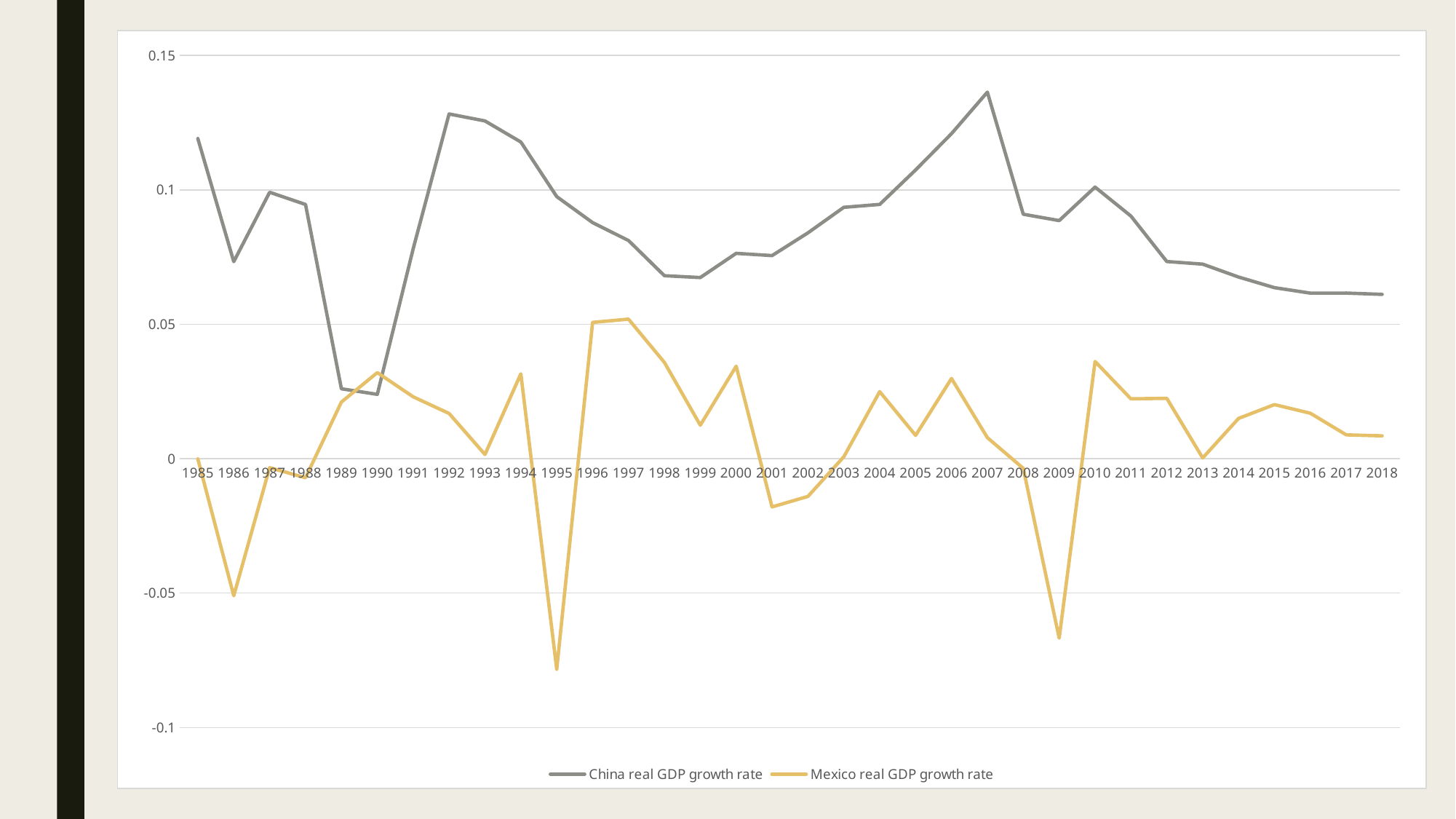
What kind of chart is shown on the slide? line chart Which series has the larger value in 2000, China real GDP growth rate or Mexico real GDP growth rate? China real GDP growth rate In which year does the China real GDP growth rate reach its highest value? 2007 How many series does the legend list? 2 Is the China real GDP growth rate in 1990 greater or less than 0.05? less Is the Mexico real GDP growth rate in 1986 greater or less than 0? less What colour is the line for the Mexico real GDP growth rate? yellow Does the China real GDP growth rate rise or fall from 2010 to 2018? fall Is the Mexico real GDP growth rate in 2009 greater or less than -0.05? less In which year does the Mexico real GDP growth rate reach its lowest value? 1995 How many years are plotted along the x axis? 34